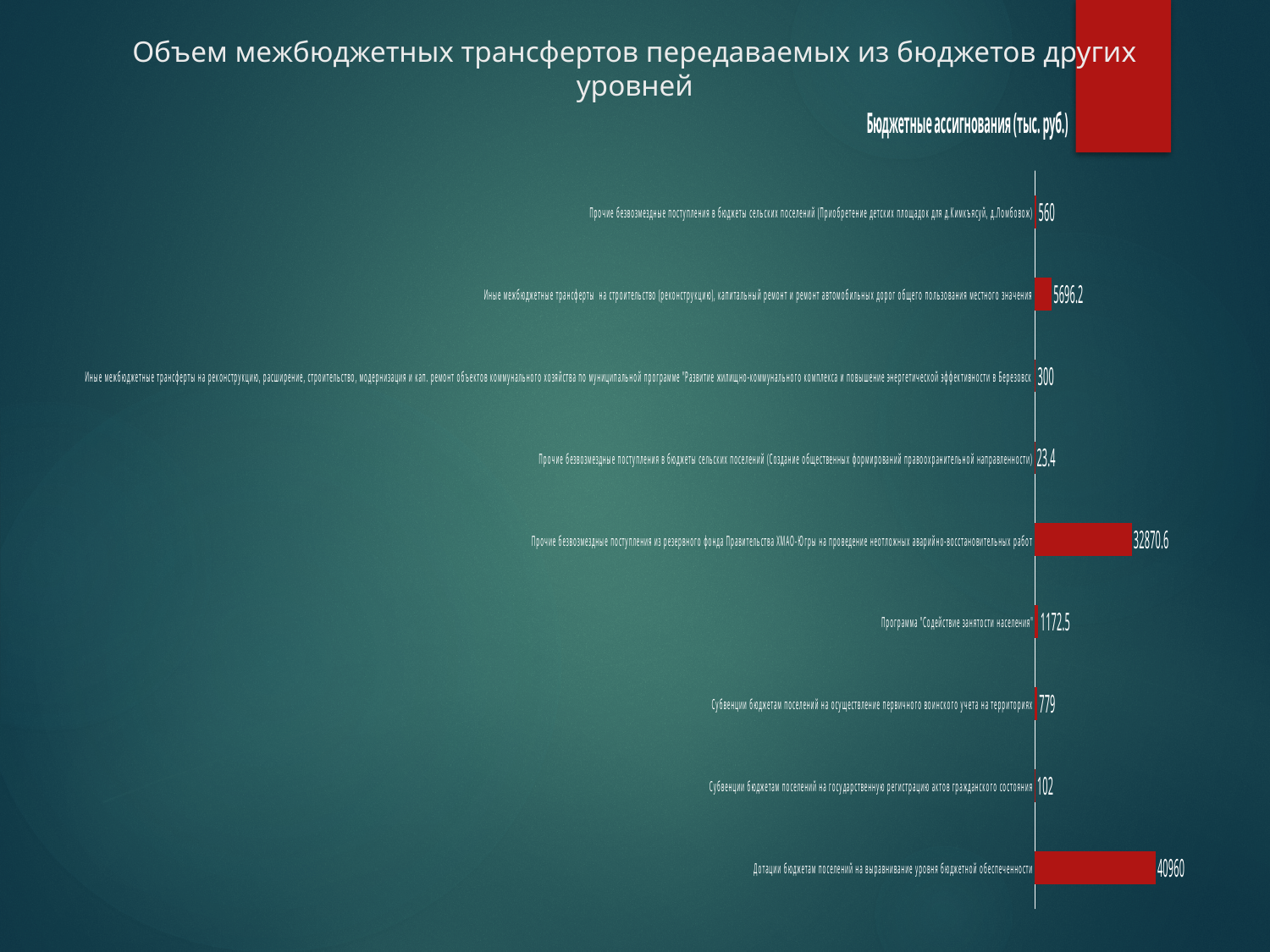
What is the difference between the value for "Дотации бюджетам поселений на выравнивание уровня бюджетной обеспеченности" and the value for "Прочие безвозмездные поступления из резервного фонда Правительства ХМАО-Югры на проведение неотложных аварийно-восстановительных работ"? 8089.4 What is the value for "Прочие безвозмездные поступления из резервного фонда Правительства ХМАО-Югры на проведение неотложных аварийно-восстановительных работ"? 32870.6 What is the value for "Дотации бюджетам поселений на выравнивание уровня бюджетной обеспеченности"? 40960 Which category has the highest value? Дотации бюджетам поселений на выравнивание уровня бюджетной обеспеченности What is the title of the chart? Бюджетные ассигнования (тыс. руб.) What kind of chart is shown on the slide? bar chart What is the value for "Программа "Содействие занятости населения""? 1172.5 Which category has the lowest value? Прочие безвозмездные поступления в бюджеты сельских поселений (Создание общественных формирований правоохранительной направленности) What is the value for "Субвенции бюджетам поселений на осуществление первичного воинского учета на территориях"? 779 What colour are the bars in the chart? red How many categories are plotted in the chart? 9 Which is larger: the value for "Субвенции бюджетам поселений на осуществление первичного воинского учета на территориях" or the value for "Субвенции бюджетам поселений на государственную регистрацию актов гражданского состояния"? Субвенции бюджетам поселений на осуществление первичного воинского учета на территориях